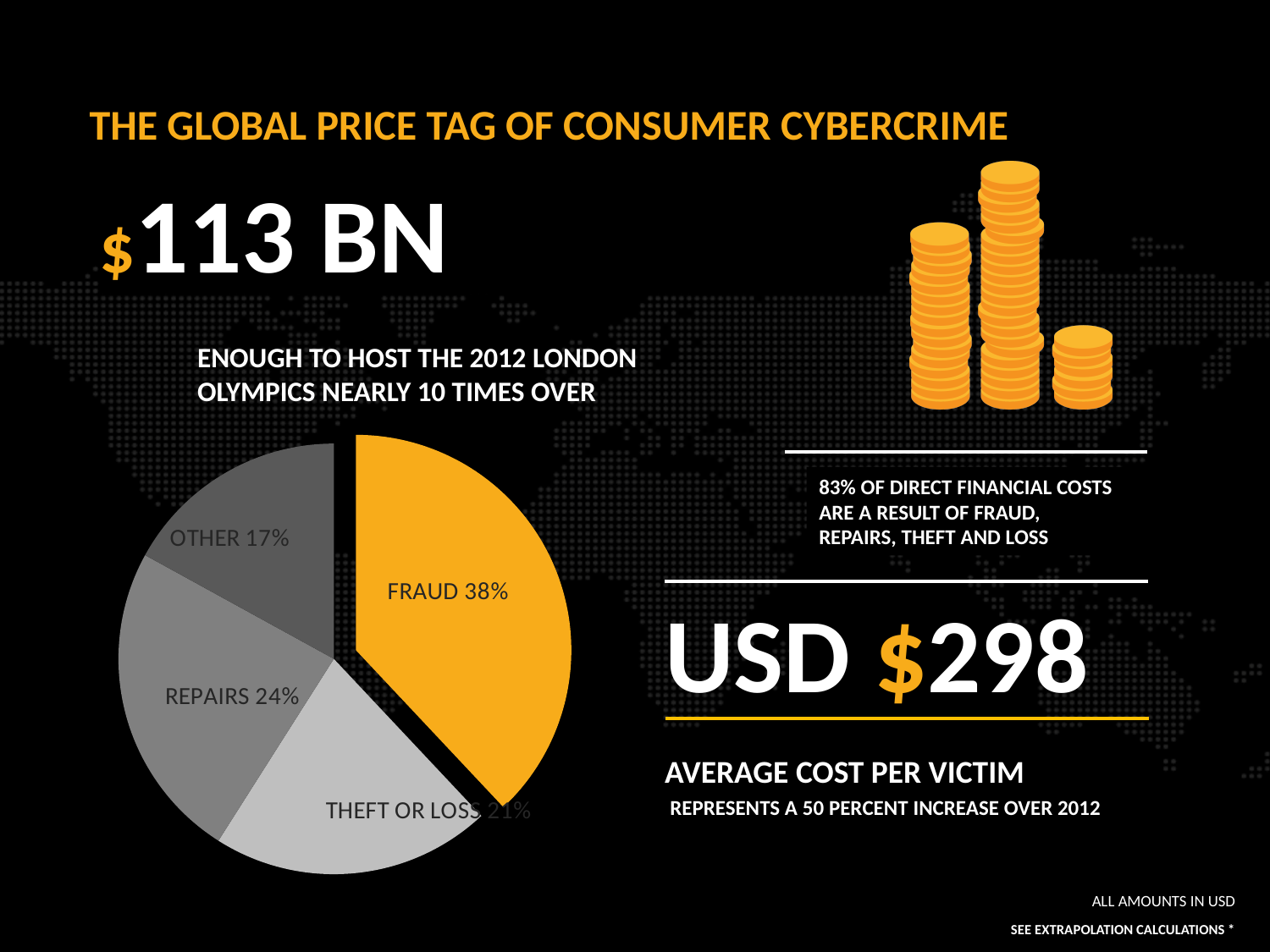
Which category has the largest slice of the pie? Fraud What is the combined share of Fraud and Repairs? 62% Which is larger, the Repairs slice or the Other slice? Repairs What share of the pie does Repairs represent? 24% What is the difference in percentage points between Fraud and Repairs? 14 Which category has the smallest slice of the pie? Other What kind of chart is shown on the slide? pie chart What share of the pie does Fraud represent? 38% How many slices does the pie chart have? 4 Which slice of the pie chart is coloured orange? Fraud What share of the pie does Other represent? 17% What is the difference in percentage points between Theft or Loss and Other? 4